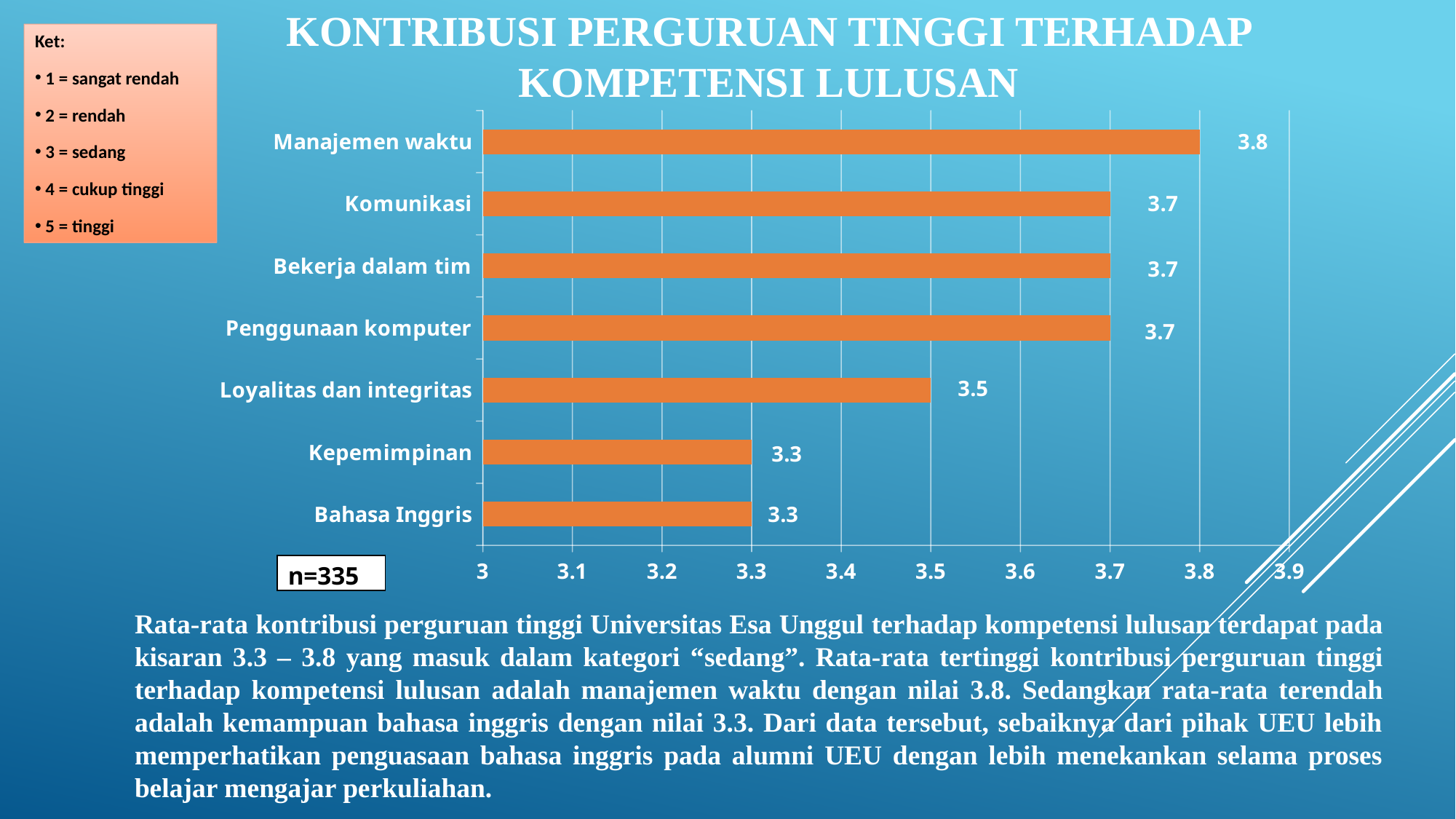
Is the value for Kepemimpinan greater or less than 3.5? less What is the value for Komunikasi? 3.7 What is the value for Bahasa Inggris? 3.3 What is the difference between the values for Penggunaan komputer and Loyalitas dan integritas? 0.2 What kind of chart is shown on the slide? bar chart Which is larger, the value for Loyalitas dan integritas or the value for Kepemimpinan? Loyalitas dan integritas What is the value for Loyalitas dan integritas? 3.5 How many categories are shown in the chart? 7 Which category has the highest value? Manajemen waktu What is the title of the chart? KONTRIBUSI PERGURUAN TINGGI TERHADAP KOMPETENSI LULUSAN What is the value for Manajemen waktu? 3.8 What is the difference between the values for Manajemen waktu and Bahasa Inggris? 0.5